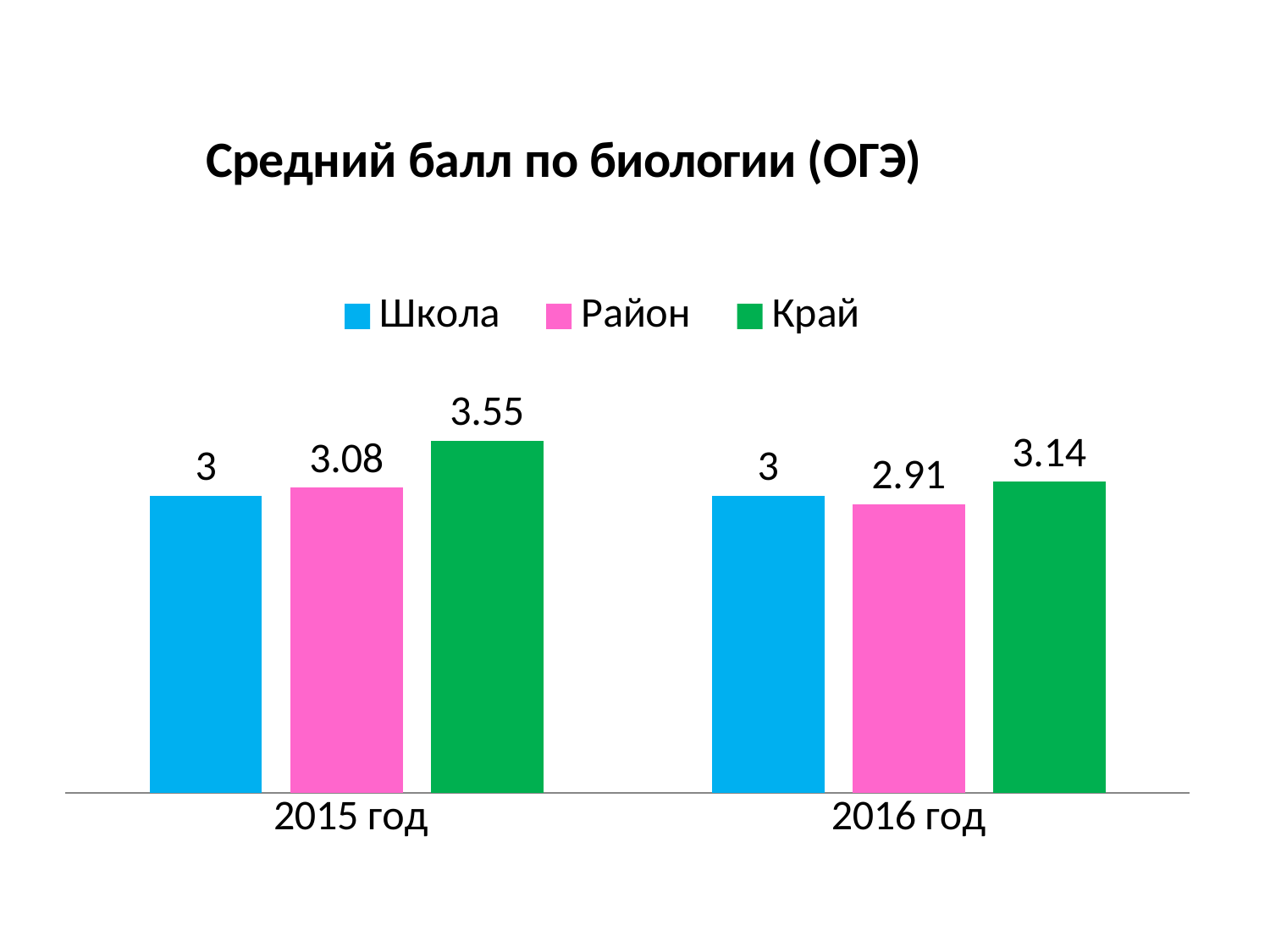
How many series does the legend list? 3 What is the title of the chart? Средний балл по биологии (ОГЭ) What kind of chart is shown on the slide? Bar chart How many categories are shown on the x axis? 2 What is the value for Школа in 2015 год? 3 Which is larger: Район in 2015 год or Район in 2016 год? Район in 2015 год What is the value for Район in 2015 год? 3.08 Which series has the highest value in 2015 год? Край What is the value for Край in 2016 год? 3.14 What is the value for Район in 2016 год? 2.91 What is the difference between the Край values for 2015 год and 2016 год? 0.41 Which series has the lowest value in 2016 год? Район